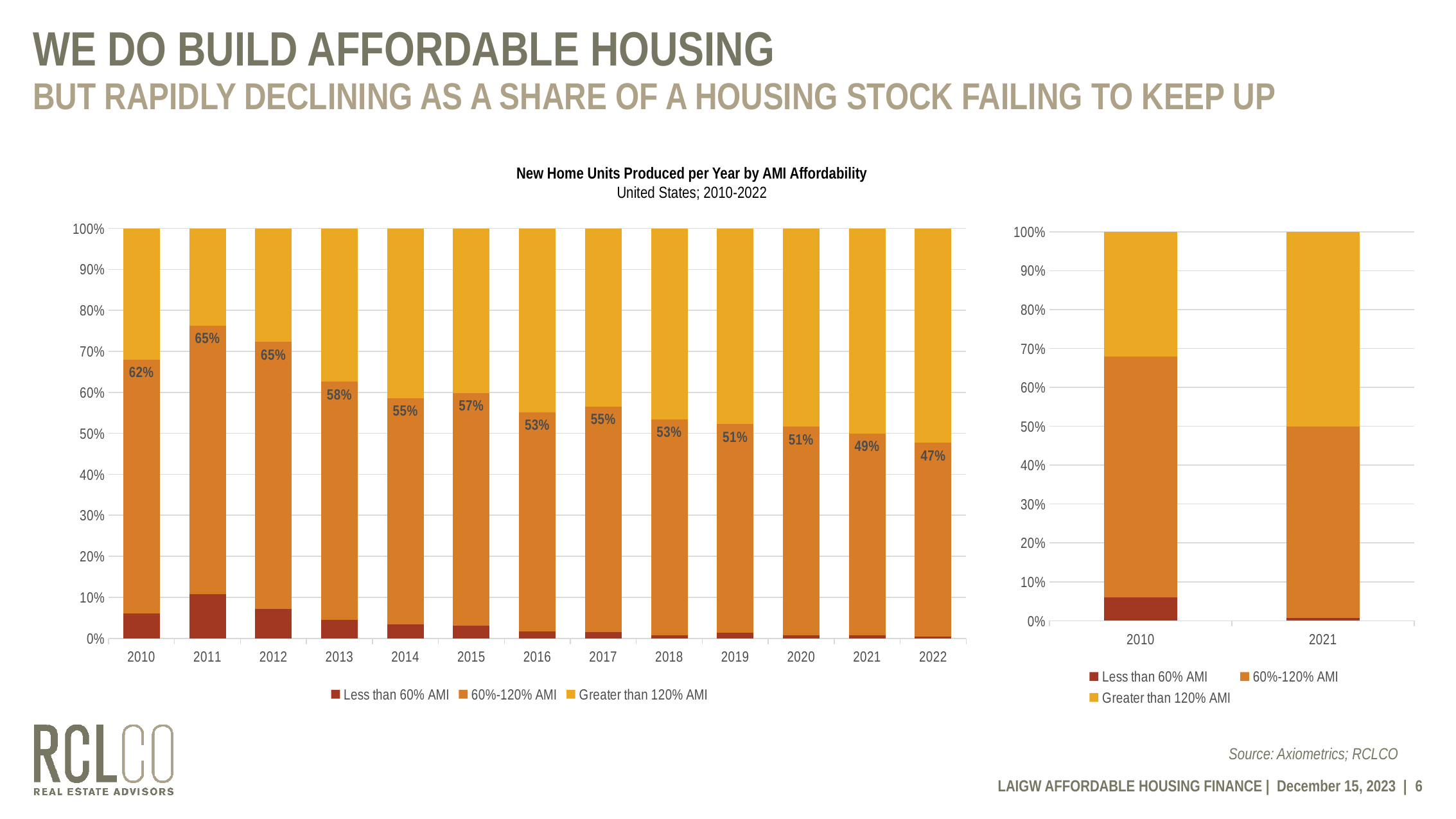
In the chart titled 'New Home Units Produced per Year by AMI Affordability', what is the labelled share for 60%-120% AMI in 2015? 57% How many years are shown on the x axis of the chart titled 'New Home Units Produced per Year by AMI Affordability'? 13 In the chart titled 'New Home Units Produced per Year by AMI Affordability', by how many percentage points does the labelled 60%-120% AMI share in 2010 exceed that in 2022? 15 percentage points In the chart titled 'New Home Units Produced per Year by AMI Affordability', does the labelled 60%-120% AMI share generally rise or fall from 2010 to 2022? Fall How many series does the legend list in the chart titled 'New Home Units Produced per Year by AMI Affordability'? 3 In the chart titled 'New Home Units Produced per Year by AMI Affordability', which year has the lowest labelled share for 60%-120% AMI? 2022 In the chart titled 'New Home Units Produced per Year by AMI Affordability', which year has a larger labelled 60%-120% AMI share, 2013 or 2016? 2013 In the chart on the right of the slide, is the top of the 60%-120% AMI segment for 2010 greater or less than 60%? greater What kind of chart is the chart titled 'New Home Units Produced per Year by AMI Affordability'? Stacked bar chart In the chart titled 'New Home Units Produced per Year by AMI Affordability', is the Less than 60% AMI share in 2010 greater or less than 10%? less In the chart titled 'New Home Units Produced per Year by AMI Affordability', what is the labelled share for 60%-120% AMI in 2022? 47% In the chart titled 'New Home Units Produced per Year by AMI Affordability', what is the labelled share for 60%-120% AMI in 2010? 62%